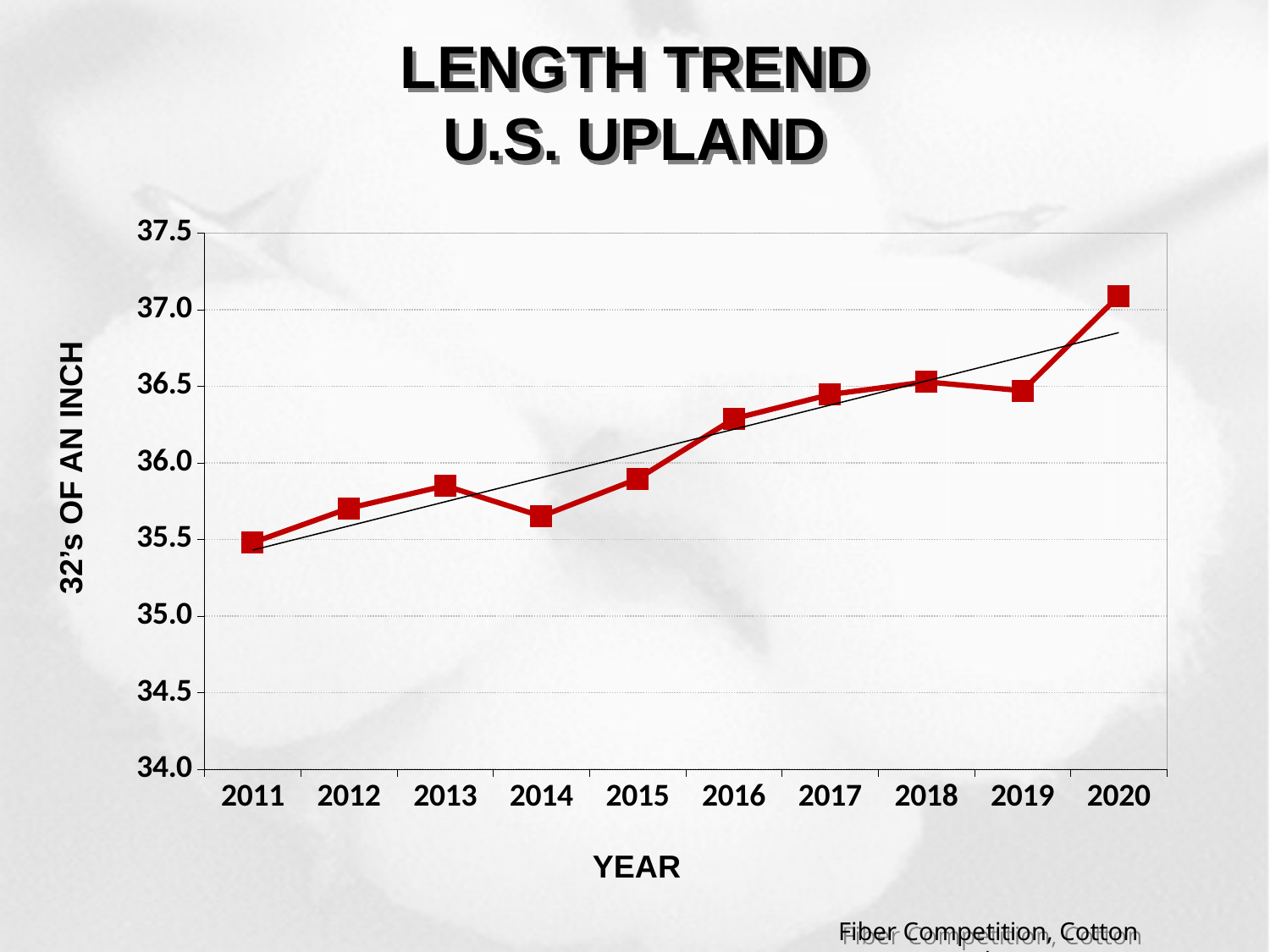
Which year has the larger value, 2015 or 2016? 2016 Which year has the lowest length value? 2011 Which year has the larger value, 2013 or 2014? 2013 Is the value for 2014 greater or less than 36.0? less Is the value for 2020 greater or less than 37.0? greater Which year has the highest length value? 2020 What kind of chart is shown on the slide? line chart How many years are plotted on the x axis? 10 Is the value for 2011 greater or less than 36.0? less Do the values generally rise or fall from 2011 to 2020? rise What is the label on the y axis? 32's OF AN INCH